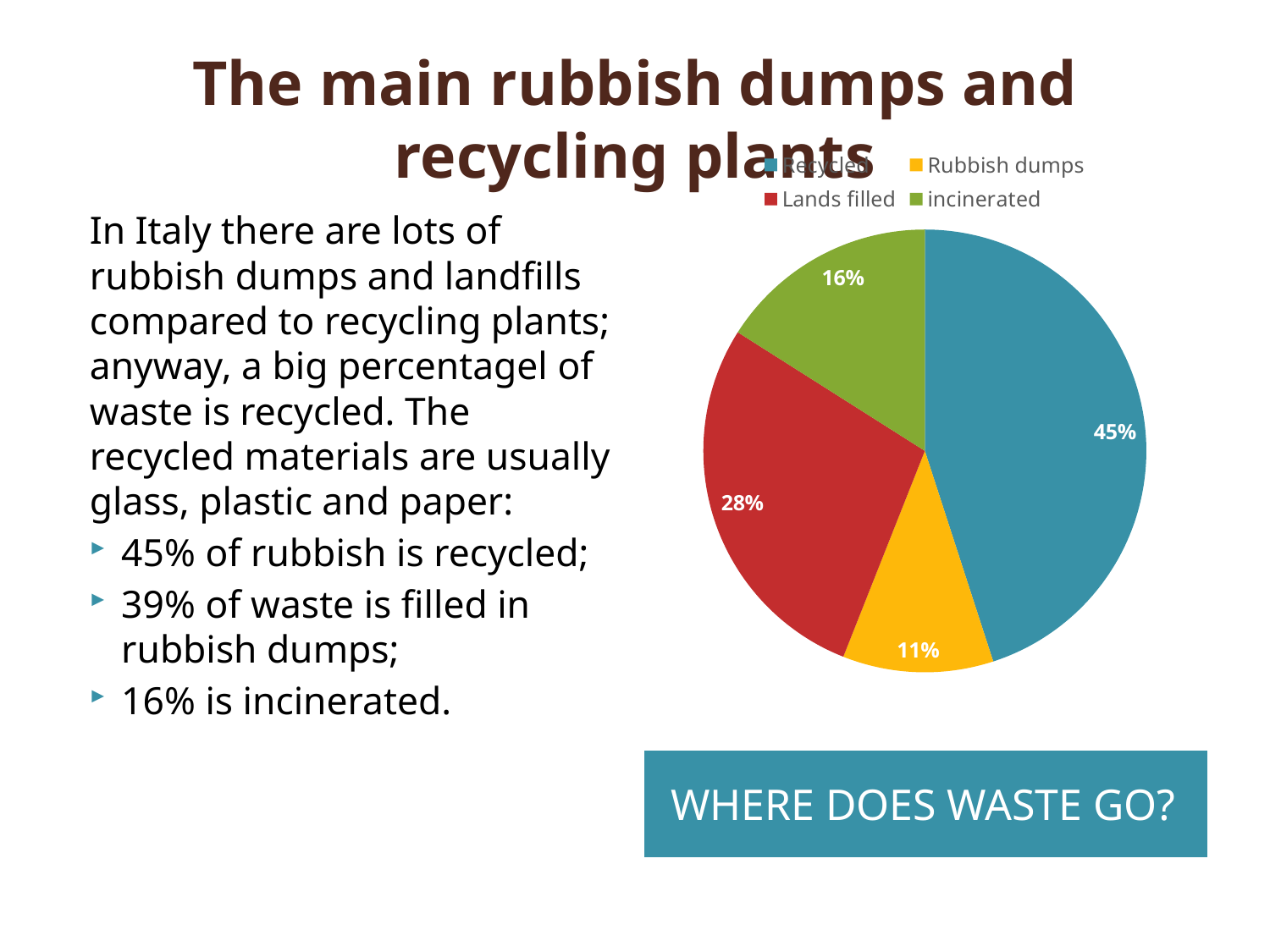
Which category has the smallest slice of the pie? Rubbish dumps How many entries does the legend list? 4 What percentage does the incinerated slice show? 16% What colour is the incinerated slice? green What percentage does the Rubbish dumps slice show? 11% What percentage does the Recycled slice show? 45% What percentage does the Lands filled slice show? 28% Which category has the largest slice of the pie? Recycled What is the difference between the Lands filled and incinerated percentages? 12% How many slices does the pie chart have? 4 Which is larger, the Lands filled slice or the Rubbish dumps slice? Lands filled What kind of chart is shown on the slide? pie chart